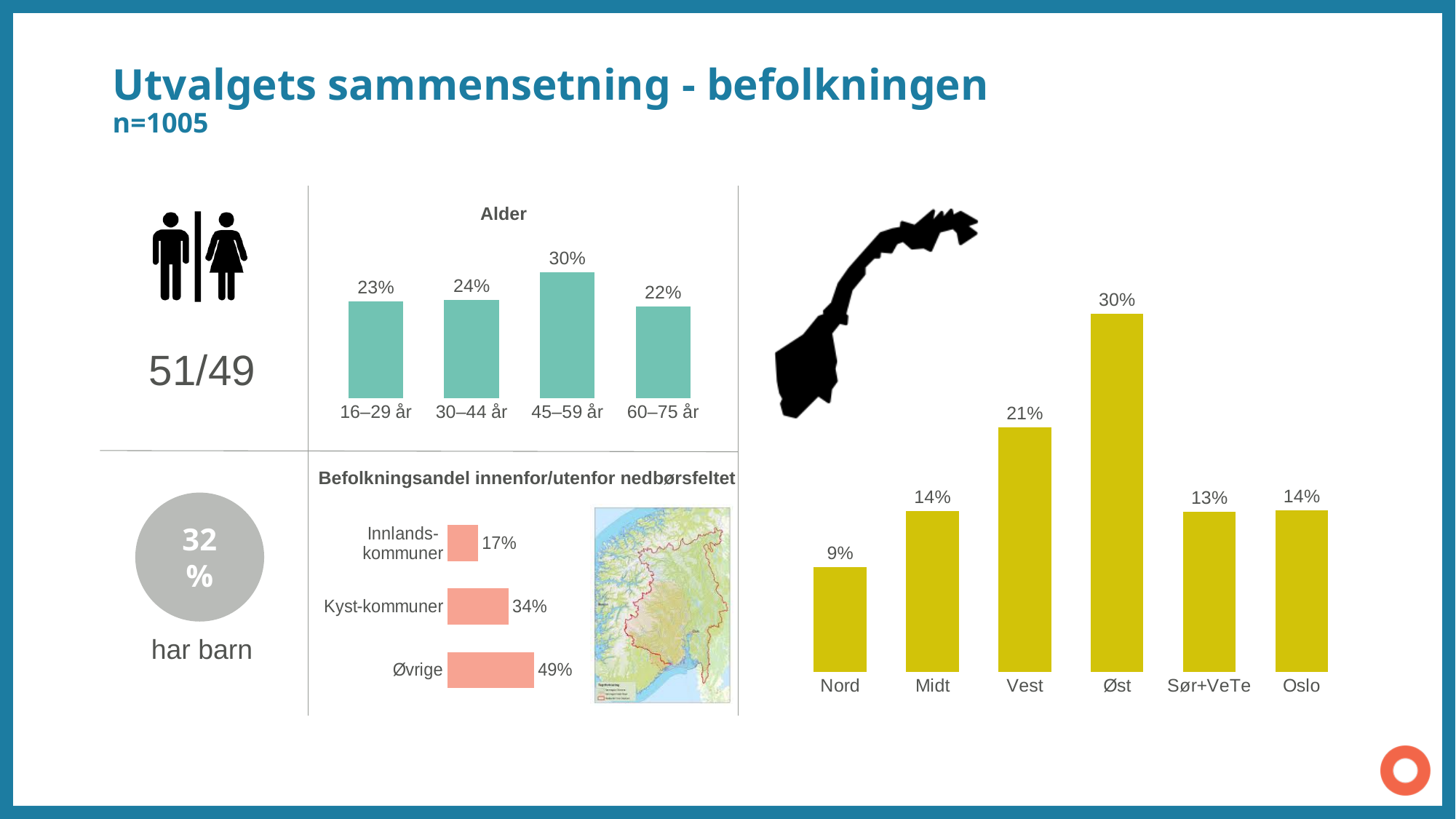
In the 'Alder' chart, which age group has the lowest value? 60–75 år In the 'Befolkningsandel innenfor/utenfor nedbørsfeltet' chart, what kind of chart is used? Bar chart In the region chart on the right side of the slide, which region has the lowest value? Nord In the 'Alder' chart, how many age groups are shown? 4 In the region chart on the right side of the slide, what is the difference between the values for Øst and Nord? 21% In the 'Alder' chart, what is the value for 45–59 år? 30% In the region chart on the right side of the slide, what is the value for Vest? 21% In the 'Alder' chart, what is the difference between the values for 45–59 år and 16–29 år? 7% In the region chart on the right side of the slide, which region has the highest value? Øst In the 'Befolkningsandel innenfor/utenfor nedbørsfeltet' chart, which category has the highest value? Øvrige In the 'Befolkningsandel innenfor/utenfor nedbørsfeltet' chart, what is the value for Kyst-kommuner? 34% In the region chart on the right side of the slide, how many regions are shown? 6